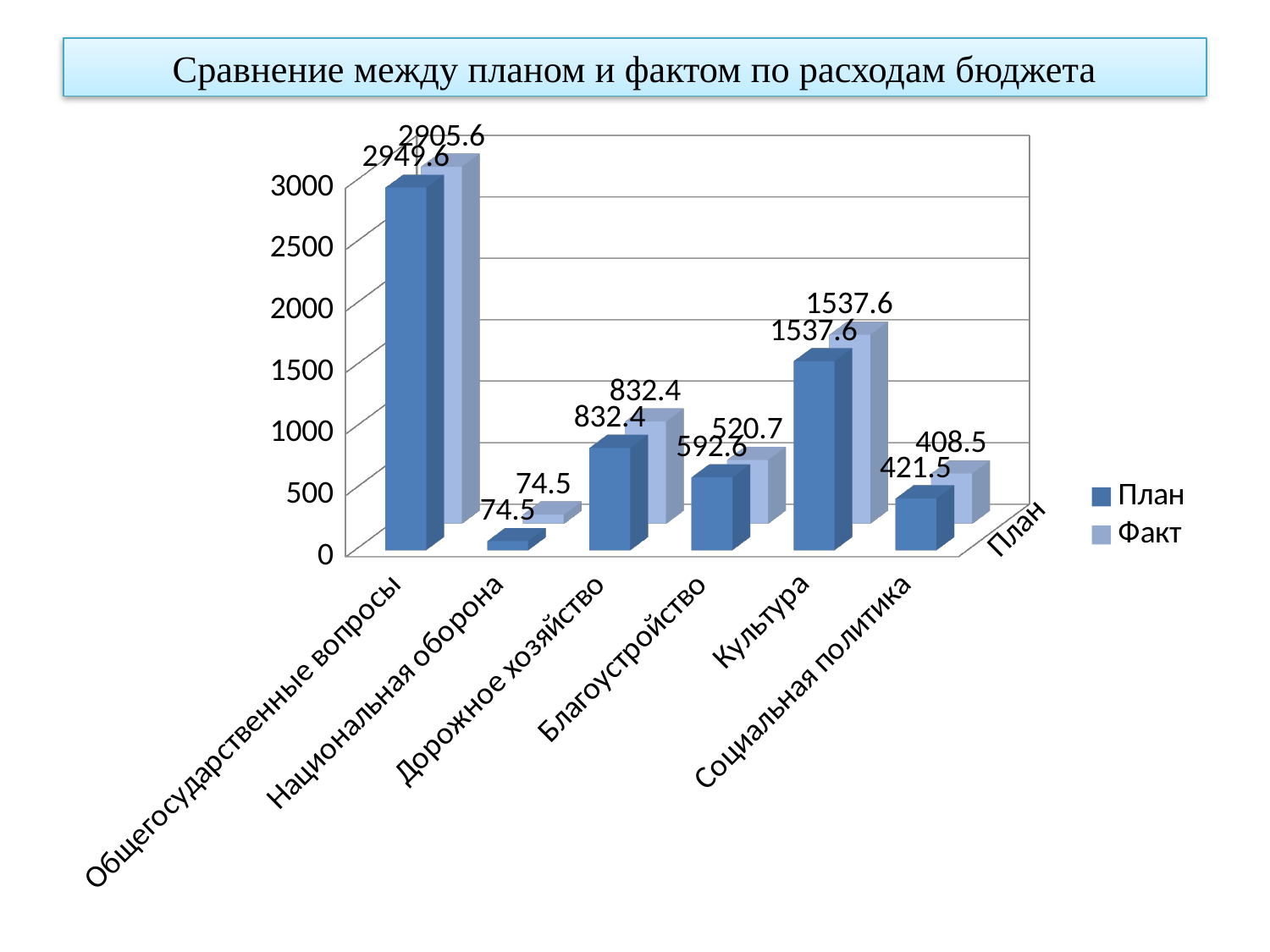
What is the Факт value for Социальная политика? 408.5 What is the difference between the План and Факт values for Общегосударственные вопросы? 44 Which category has the lowest Факт value? Национальная оборона How many categories are shown on the x axis? 6 What is the План value for Культура? 1537.6 What kind of chart is shown on the slide? Bar chart Which category has the highest План value? Общегосударственные вопросы Which is larger, the План value for Дорожное хозяйство or the План value for Благоустройство? Дорожное хозяйство What is the difference between the План and Факт values for Благоустройство? 71.9 What is the Факт value for Благоустройство? 520.7 What is the План value for Общегосударственные вопросы? 2949.6 How many series does the legend list? 2